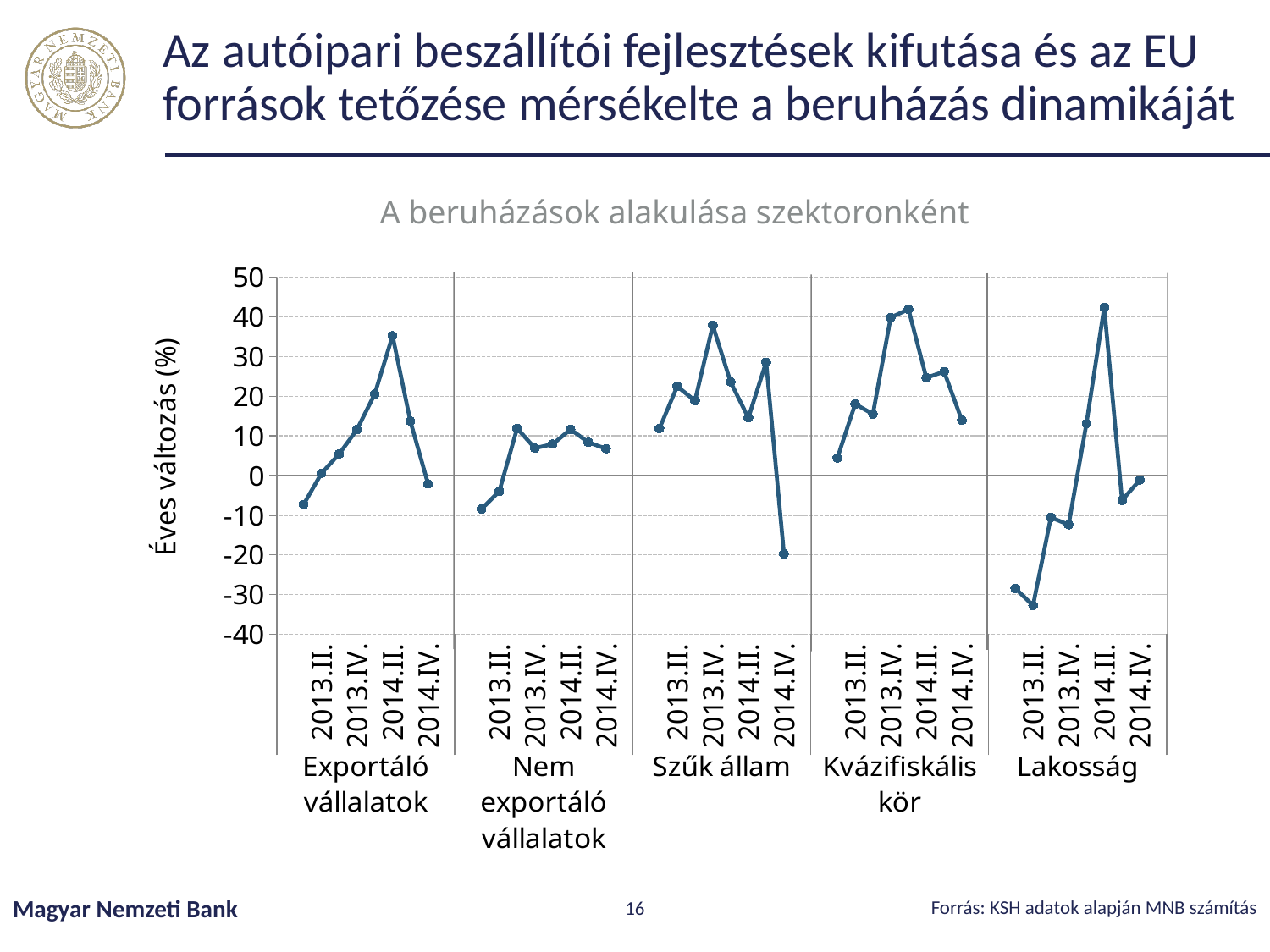
Which sector contains the lowest value plotted in the chart? Lakosság Is the value for Nem exportáló vállalatok at 2014.IV. greater or less than 10? less Is the value for Kvázifiskális kör at 2013.IV. greater or less than 30? greater How many sectors (panels) are shown in the chart? 5 Is the value for Lakosság at 2013.II. greater or less than -20? less What kind of chart is shown on the slide? line chart What is the title of the chart? A beruházások alakulása szektoronként What is the label of the vertical axis? Éves változás (%) Do the values for Exportáló vállalatok rise or fall from 2013.II. to 2014.II.? rise